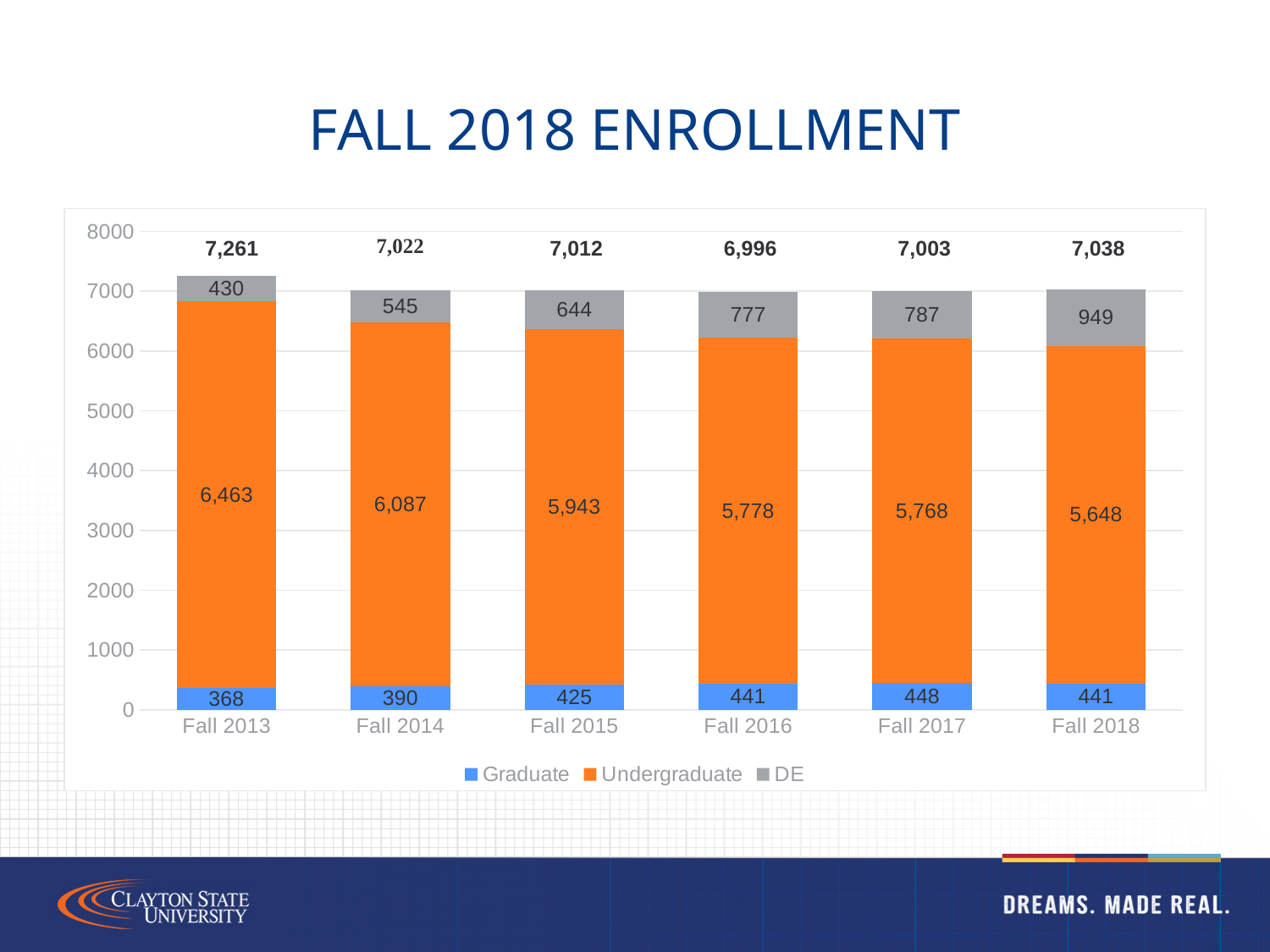
What is the difference between the Undergraduate enrollment in Fall 2013 and Fall 2018? 815 How many series does the legend list? 3 What is the Graduate enrollment for Fall 2013? 368 Which term has the highest total enrollment? Fall 2013 Which term has the lowest DE enrollment? Fall 2013 How many terms are shown on the x axis? 6 What is the Undergraduate enrollment for Fall 2015? 5,943 Is the Undergraduate value for Fall 2016 greater or less than 6000? less What kind of chart is shown on the slide? Stacked bar chart What is the DE enrollment for Fall 2018? 949 Which is larger, the Graduate enrollment in Fall 2017 or in Fall 2014? Fall 2017 What is the total enrollment for Fall 2016? 6,996